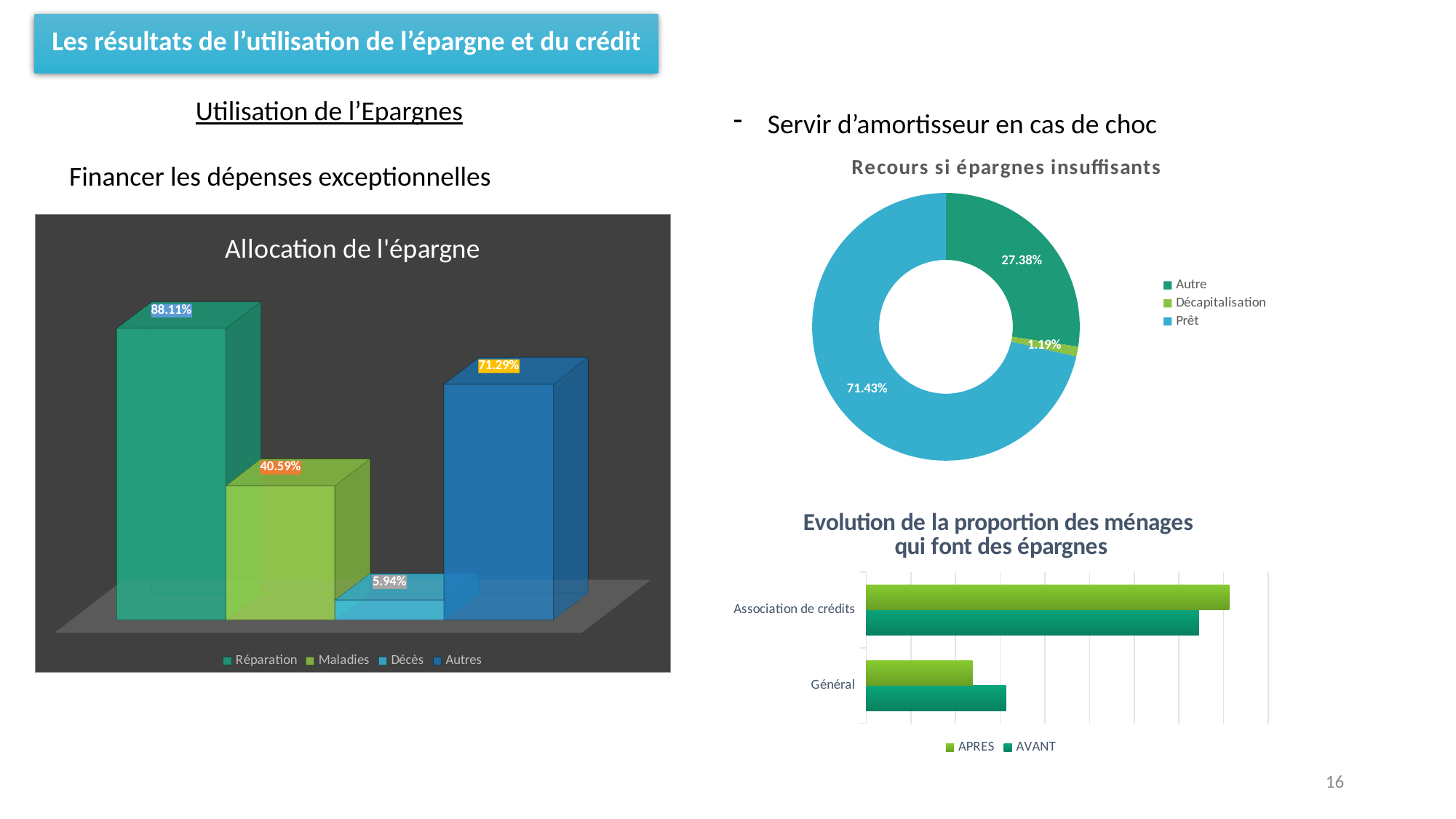
In the 'Allocation de l'épargne' chart, what is the value for Réparation? 88.11% In the 'Allocation de l'épargne' chart, what is the value for Maladies? 40.59% In the 'Allocation de l'épargne' chart, how many categories does the legend list? 4 In the 'Evolution de la proportion des ménages qui font des épargnes' chart, how many series does the legend list? 2 In the 'Allocation de l'épargne' chart, which category has the highest value? Réparation In the 'Allocation de l'épargne' chart, which category has the lowest value? Décès In the 'Recours si épargnes insuffisants' chart, which category has the largest share? Prêt In the 'Allocation de l'épargne' chart, what is the difference between the values for Réparation and Autres? 16.82% What kind of chart is 'Evolution de la proportion des ménages qui font des épargnes'? Bar chart In the 'Recours si épargnes insuffisants' chart, what share does Prêt have? 71.43% In the 'Recours si épargnes insuffisants' chart, what is the value for Décapitalisation? 1.19% In the 'Evolution de la proportion des ménages qui font des épargnes' chart, for Général, which series is larger, APRES or AVANT? AVANT